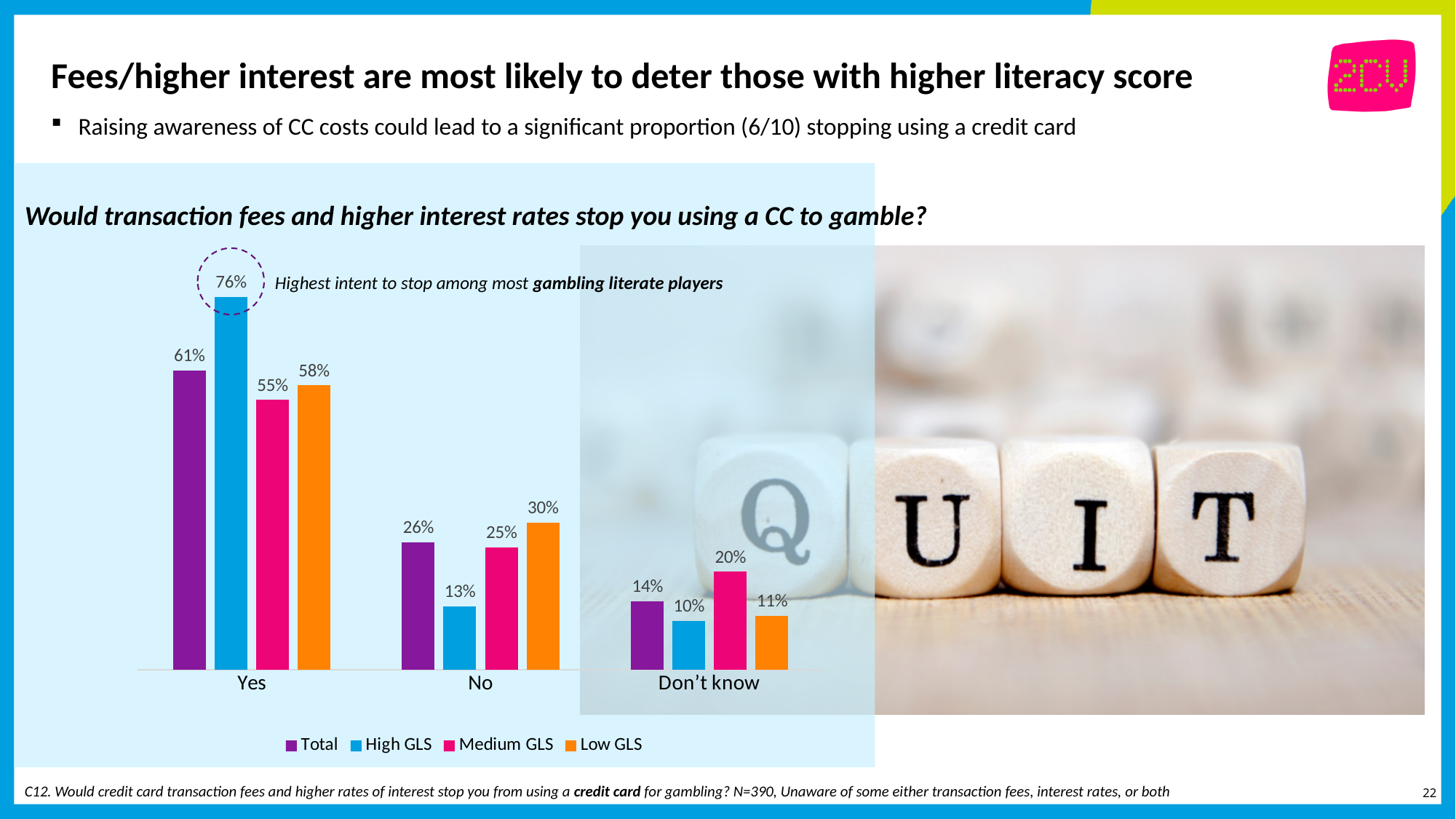
Which is larger for 'Don't know': the Medium GLS value or the Total value? Medium GLS What percentage of Low GLS respondents answered 'Don't know'? 11% How many response categories are shown on the x axis? 3 What percentage of High GLS respondents answered 'Yes'? 76% What is the difference between the High GLS and Low GLS values for 'Yes'? 18% Which series has the highest value in the 'Yes' category? High GLS Which series has the lowest value in the 'No' category? High GLS What is the Total value for the 'No' category? 26% How many series does the legend list? 4 What is the Medium GLS value for the 'Yes' category? 55% Which series is shown in orange in the legend? Low GLS What type of chart is shown on the slide? Bar chart